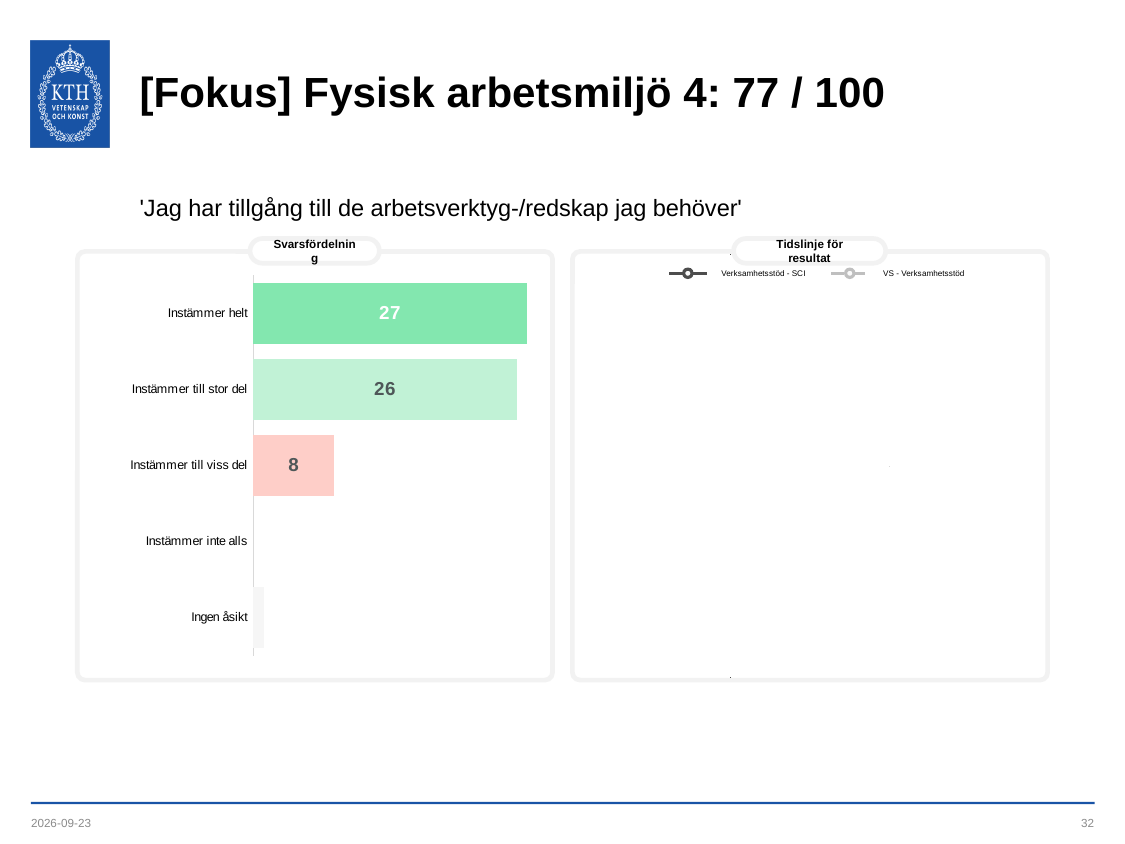
In the 'Svarsfördelning' chart, which category has the highest value? Instämmer helt What are the two legend entries of the 'Tidslinje för resultat' chart? Verksamhetsstöd - SCI and VS - Verksamhetsstöd How many series does the legend of the 'Tidslinje för resultat' chart list? 2 What is the title of the chart on the left side of the slide? Svarsfördelning In the 'Svarsfördelning' chart, what is the difference between 'Instämmer till stor del' and 'Instämmer till viss del'? 18 In the 'Svarsfördelning' chart, what is the value for 'Instämmer helt'? 27 What kind of chart is the 'Svarsfördelning' chart? Bar chart In the 'Svarsfördelning' chart, what is the value for 'Instämmer till stor del'? 26 In the 'Svarsfördelning' chart, which is larger: 'Instämmer till viss del' or 'Instämmer till stor del'? Instämmer till stor del In the 'Svarsfördelning' chart, what is the value for 'Instämmer till viss del'? 8 How many categories are listed on the 'Svarsfördelning' chart? 5 In the 'Svarsfördelning' chart, what is the difference between 'Instämmer helt' and 'Instämmer till stor del'? 1